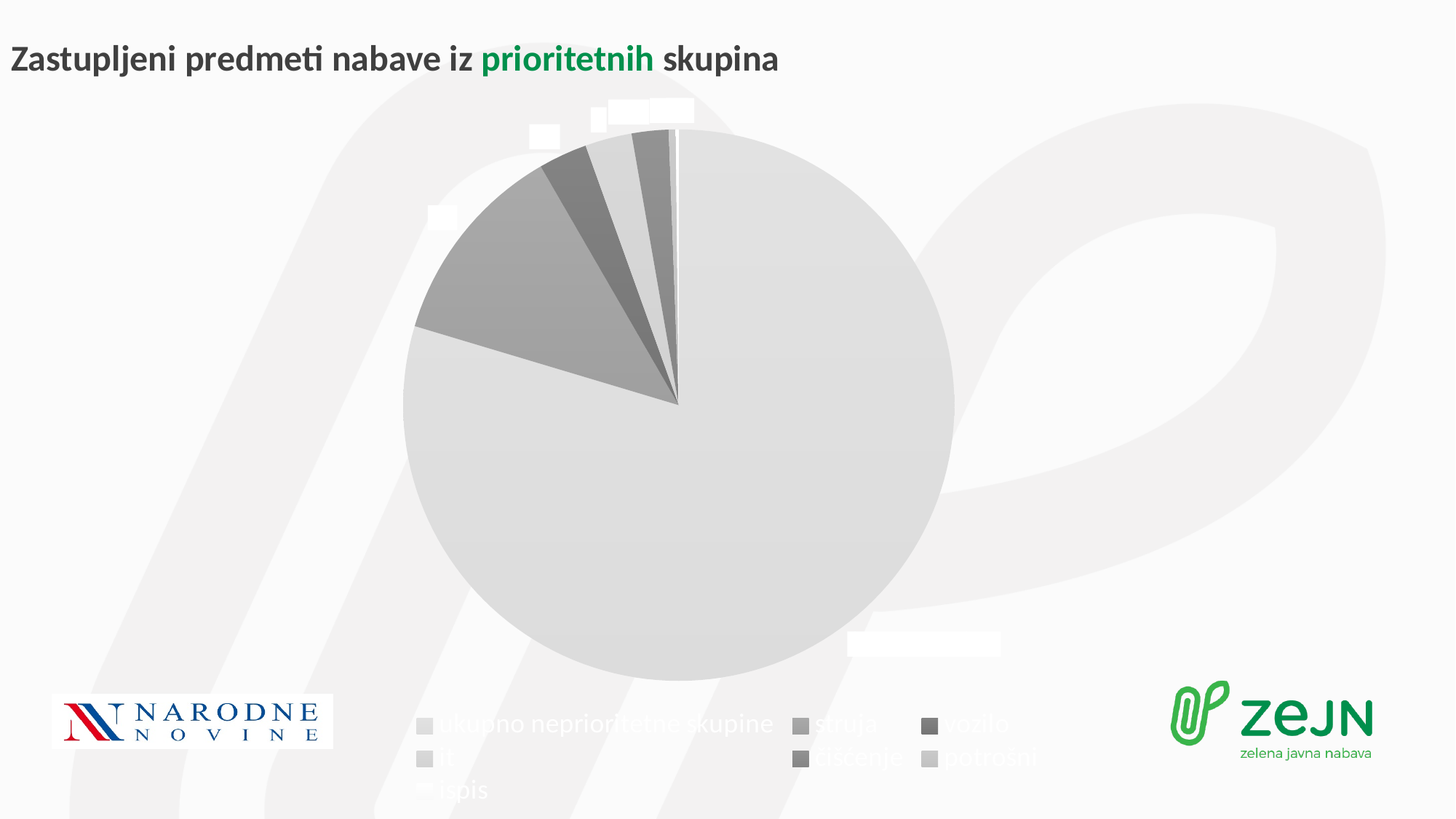
Which slice is larger, ukupno neprioritetne skupine or struja? ukupno neprioritetne skupine What kind of chart is shown on the slide? pie chart How many categories does the legend of the pie chart list? 7 Which category has the largest slice of the pie? ukupno neprioritetne skupine What is the title of the chart? Zastupljeni predmeti nabave iz prioritetnih skupina Which slice is larger, struja or čišćenje? struja Which category is listed first in the legend? ukupno neprioritetne skupine Which slice is larger, struja or vozilo? struja